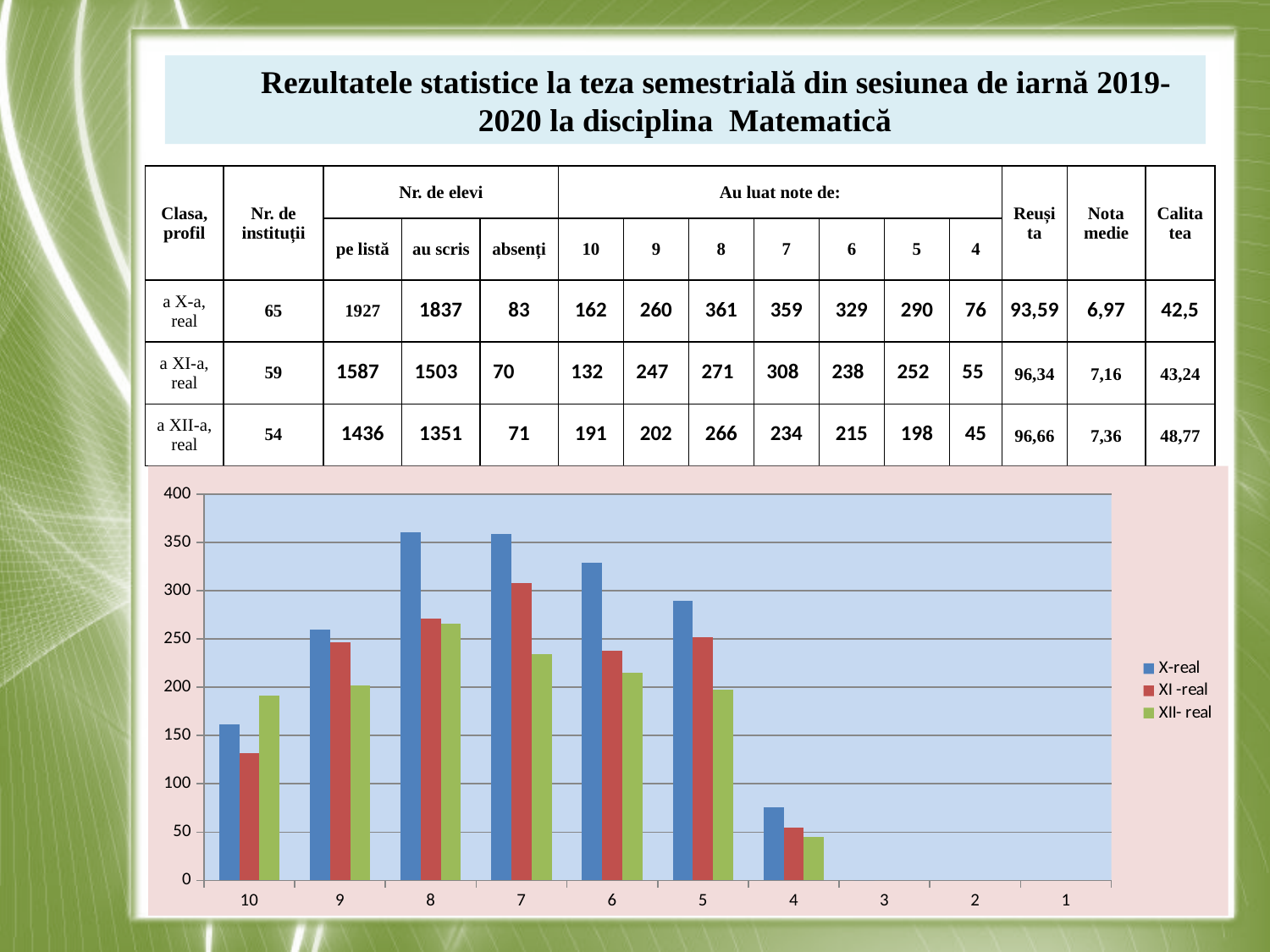
For the XII- real series, which grade category has the tallest bar? 8 Do the X-real bars rise or fall going from grade 6 to grade 4 along the x axis? fall What kind of chart is shown at the bottom of the slide? bar chart Is the X-real value for grade 4 greater or less than 100? less Is the XI -real value for grade 10 greater or less than 100? greater At grade 10, which series has the larger value, X-real or XII- real? XII- real For the XI -real series, which grade category has the tallest bar? 7 At grade 7, which series has the larger value, XI -real or XII- real? XI -real For the X-real series, which grade category with a bar has the lowest value? 4 How many categories are marked along the x axis of the chart? 10 How many series does the chart legend list? 3 Is the X-real value for grade 6 greater or less than 300? greater